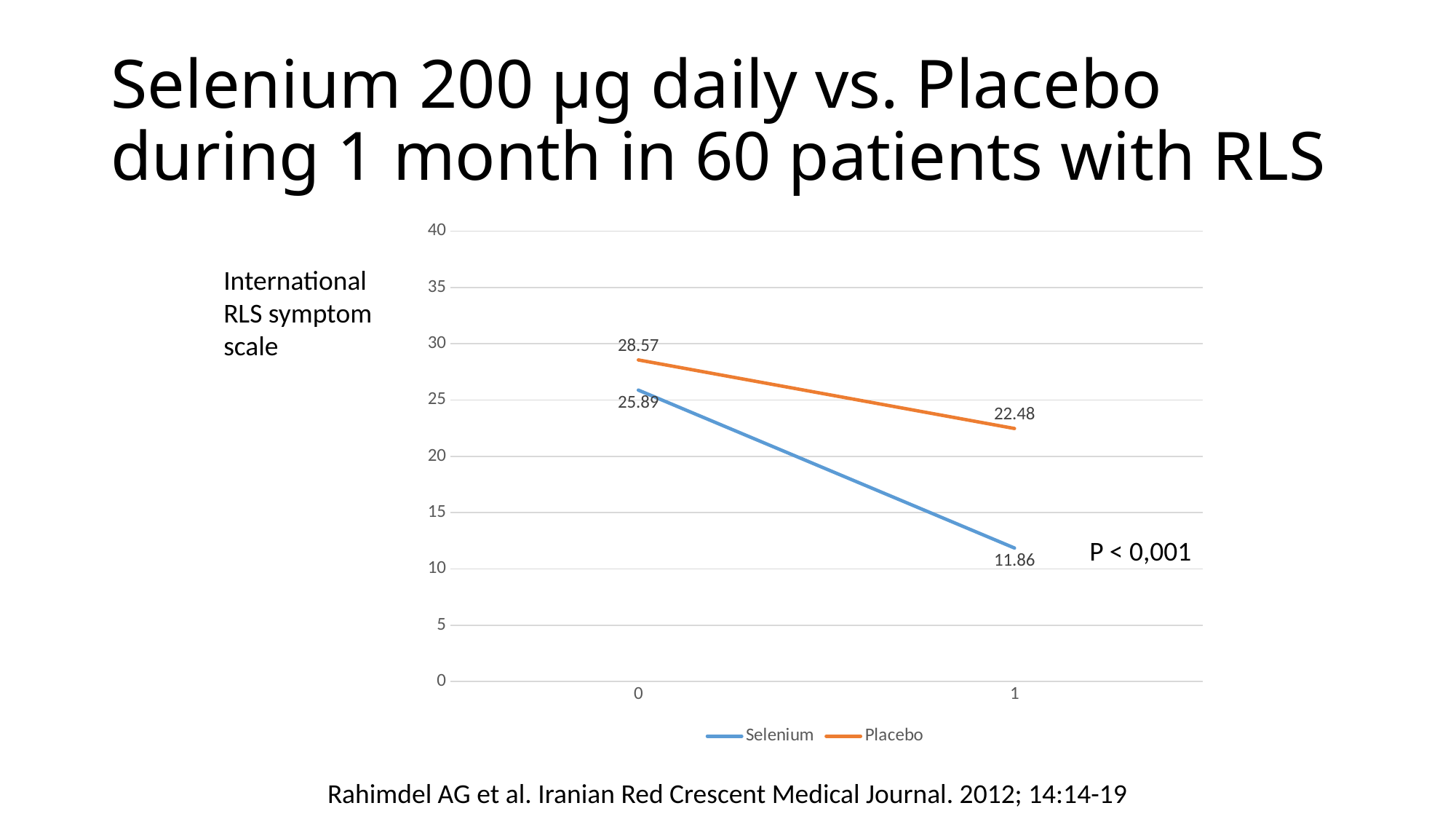
How many series does the legend list? 2 What is the Placebo value at x = 0? 28.57 Do the Selenium values rise or fall from x = 0 to x = 1? Fall Which series has the lower value at x = 1? Selenium Is the Selenium value at x = 1 greater or less than 15? less What is the Selenium value at x = 0? 25.89 Which series has the higher value at x = 0? Placebo What is the Placebo value at x = 1? 22.48 By how much did the Selenium value decrease from x = 0 to x = 1? 14.03 What is the Selenium value at x = 1? 11.86 What is the difference between the Placebo and Selenium values at x = 1? 10.62 What kind of chart is shown on the slide? Line chart